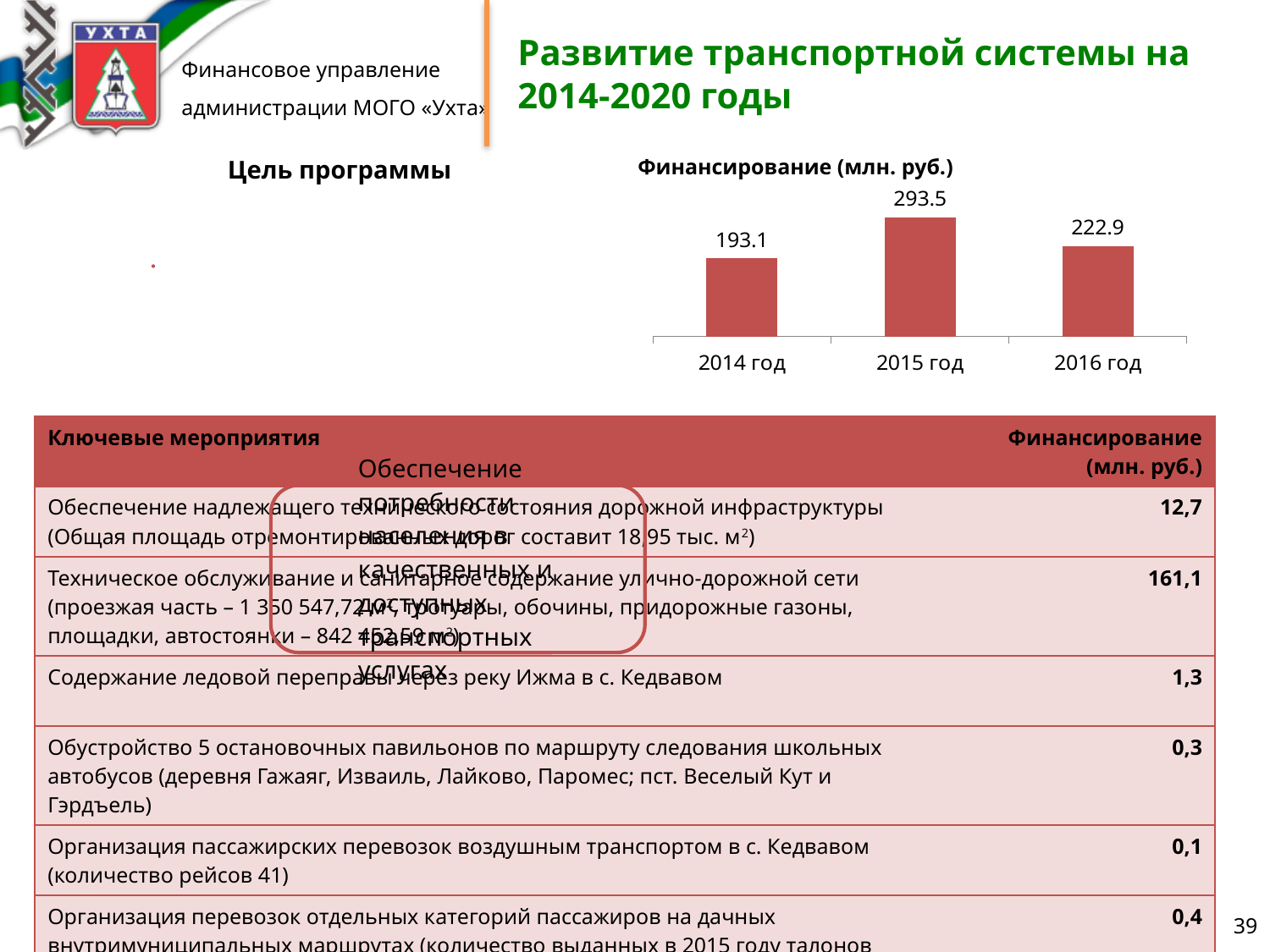
What is the difference between the values for 2015 год and 2014 год in the Финансирование (млн. руб.) chart? 100.4 Which year has the highest value in the Финансирование (млн. руб.) chart? 2015 год How many years (categories) are shown in the Финансирование (млн. руб.) chart? 3 What is the title of the chart on the slide? Финансирование (млн. руб.) What is the value for 2014 год in the Финансирование (млн. руб.) chart? 193.1 What is the value for 2016 год in the Финансирование (млн. руб.) chart? 222.9 Which year has the lowest value in the Финансирование (млн. руб.) chart? 2014 год What kind of chart is the Финансирование (млн. руб.) chart? Bar chart What is the difference between the values for 2015 год and 2016 год in the Финансирование (млн. руб.) chart? 70.6 What is the value for 2015 год in the Финансирование (млн. руб.) chart? 293.5 Which is larger in the Финансирование (млн. руб.) chart: the value for 2016 год or the value for 2014 год? 2016 год Does the value in the Финансирование (млн. руб.) chart rise or fall from 2015 год to 2016 год? Fall